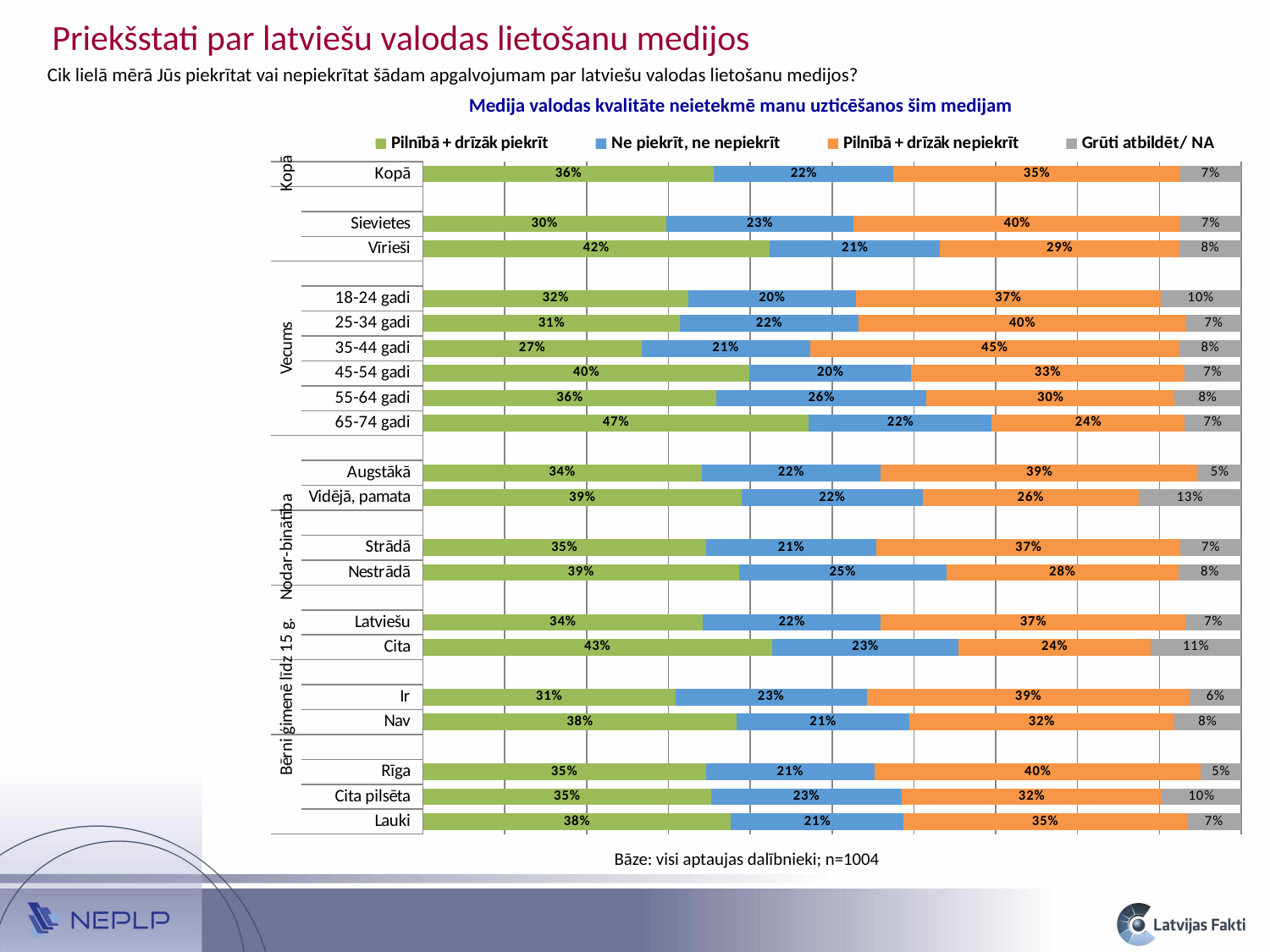
Which category has the highest value for "Pilnībā + drīzāk nepiekrīt"? 35-44 gadi Which is larger: the "Ne piekrīt, ne nepiekrīt" value for 55-64 gadi or for 45-54 gadi? 55-64 gadi How many series does the legend list? 4 What is the value of "Grūti atbildēt/ NA" for Vidējā, pamata? 13% Which category has the lowest value for "Pilnībā + drīzāk piekrīt"? 35-44 gadi What is the value of "Ne piekrīt, ne nepiekrīt" for Nestrādā? 25% Which category has the highest value for "Pilnībā + drīzāk piekrīt"? 65-74 gadi What is the difference between the "Pilnībā + drīzāk piekrīt" values for Vīrieši and Sievietes? 12 percentage points What is the value of "Pilnībā + drīzāk nepiekrīt" for Sievietes? 40% What is the value of "Pilnībā + drīzāk piekrīt" for Kopā? 36% What type of chart is shown on the slide? Stacked bar chart What is the total of the stacked bar for Kopā? 100%